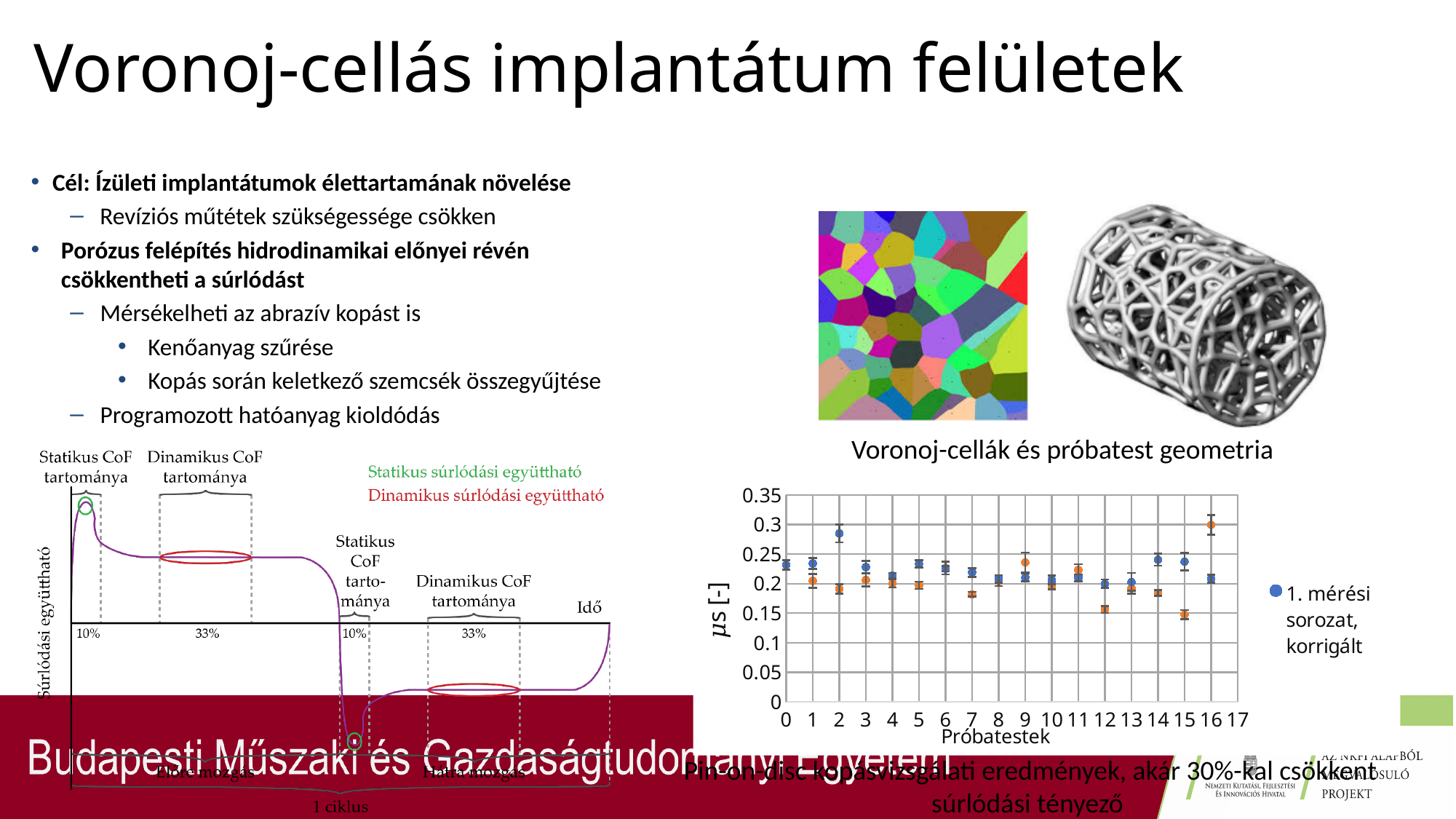
In the chart on the right, at which próbatest does the orange series reach its highest value? 16 In the chart on the right, what is the label of the x axis? Próbatestek In the chart on the right, is the orange value for próbatest 15 greater or less than 0.2? less In the chart on the right, is the orange value for próbatest 16 greater or less than 0.25? greater In the chart on the right, is the blue value for próbatest 2 greater or less than 0.25? greater In the chart on the right, what legend entry is shown for the blue series? 1. mérési sorozat, korrigált What kind of chart is the chart on the right with the x axis labelled 'Próbatestek'? scatter chart In the chart on the right, at which próbatest does the blue series reach its highest value? 2 In the chart on the right, what is the highest value shown on the y axis? 0.35 In the chart on the right, for próbatest 16, which series has the larger value, blue or orange? orange In the chart on the right, for próbatest 2, which series has the larger value, blue or orange? blue